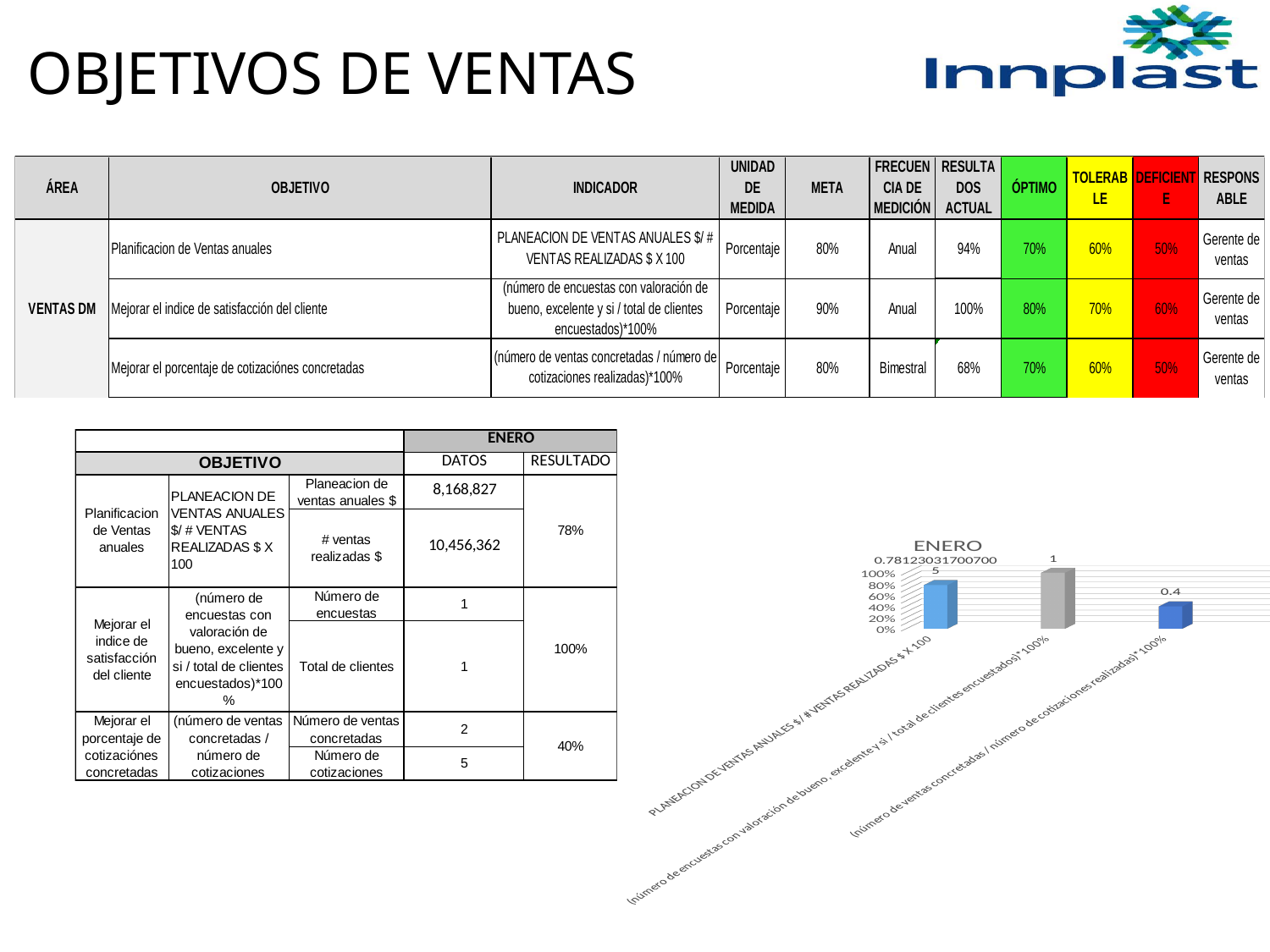
What is the difference between the bar labelled 1 and the bar labelled 0.4? 0.6 How many bars are plotted in the ENERO chart? 3 Is the value for '(número de ventas concretadas / número de cotizaciones realizadas)*100%' greater or less than 60%? less What is the highest tick value shown on the vertical axis of the ENERO chart? 100% What kind of chart is shown on the slide? bar chart Which is larger: the bar for 'PLANEACION DE VENTAS ANUALES $/ # VENTAS REALIZADAS $ X 100' or the bar for '(número de ventas concretadas / número de cotizaciones realizadas)*100%'? PLANEACION DE VENTAS ANUALES $/ # VENTAS REALIZADAS $ X 100 Is the value for 'PLANEACION DE VENTAS ANUALES $/ # VENTAS REALIZADAS $ X 100' greater or less than 60%? greater Which category has the highest bar in the ENERO chart? (número de encuestas con valoración de bueno, excelente y si / total de clientes encuestados)*100% Which category has the lowest bar in the ENERO chart? (número de ventas concretadas / número de cotizaciones realizadas)*100% What is the value of the bar for '(número de ventas concretadas / número de cotizaciones realizadas)*100%'? 0.4 What is the title of the chart? ENERO What is the value of the bar for '(número de encuestas con valoración de bueno, excelente y si / total de clientes encuestados)*100%'? 1